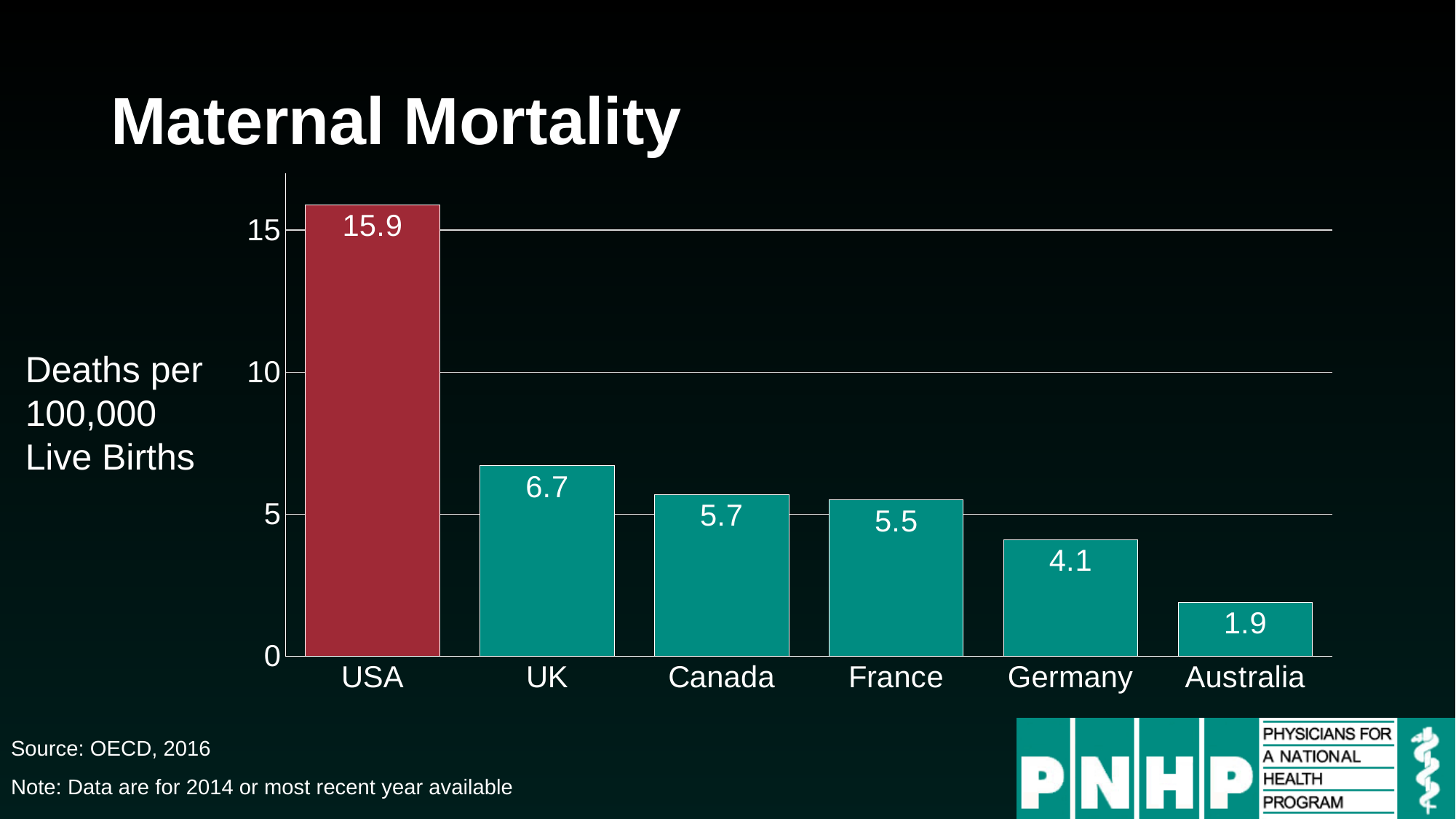
How many countries are shown on the chart? 6 Which country has the highest maternal mortality on the chart? USA What is the difference between the USA value and the UK value? 9.2 Which bar is coloured differently (red) from the others? USA What is the value shown for Germany? 4.1 Which has a higher value, the UK or Germany? UK Is the value for the USA greater or less than 15? greater What kind of chart is shown on the slide? Bar chart What is the maternal mortality value for the USA? 15.9 Which country has the lowest maternal mortality on the chart? Australia What is the difference between the France value and the Australia value? 3.6 What is the value shown for Canada? 5.7